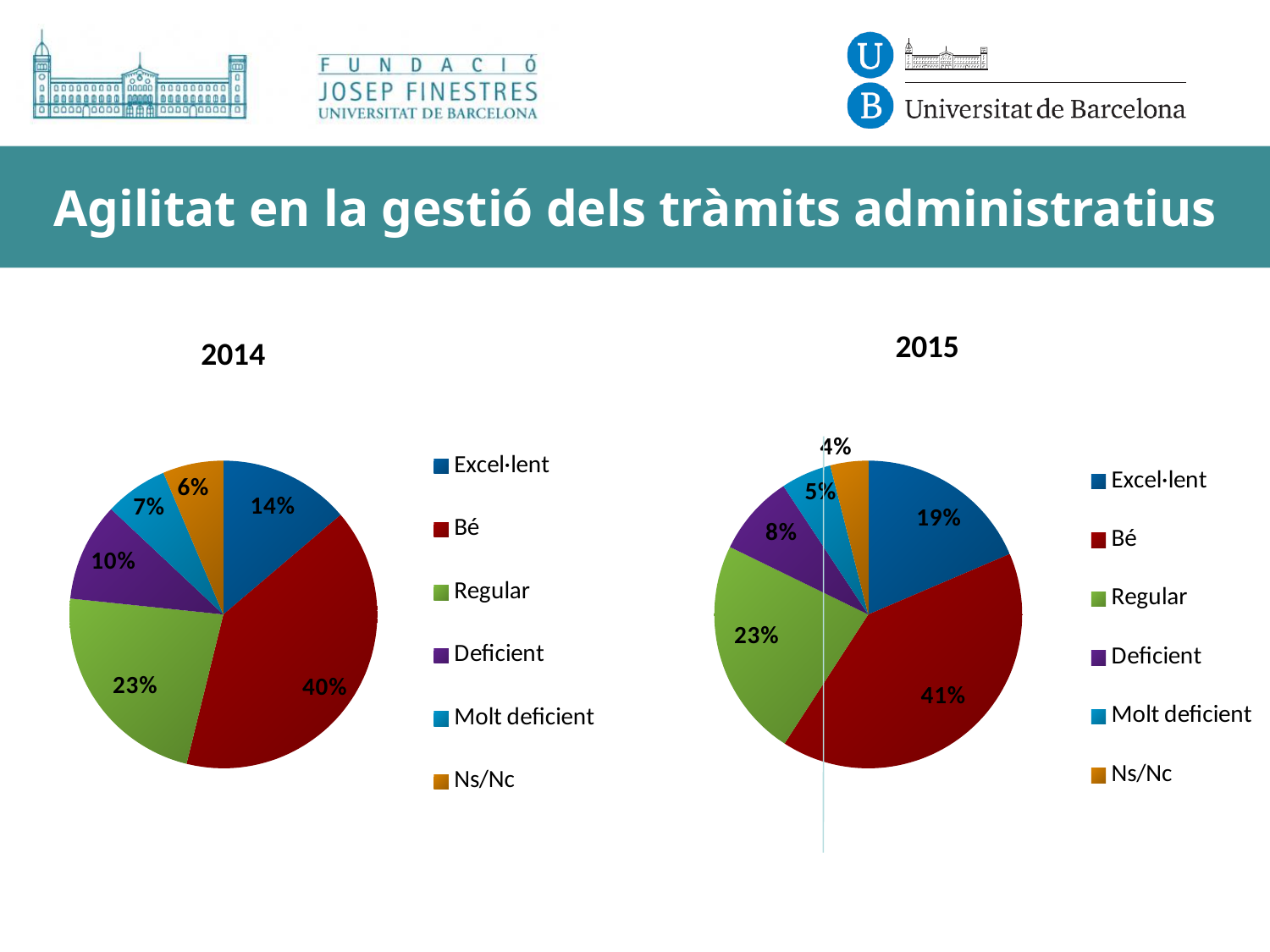
In the 2014 pie chart, what is the difference between the Bé and Regular percentages? 17% In the 2014 pie chart, what percentage is shown for Deficient? 10% What is the title of the chart on the left? 2014 In the 2015 pie chart, what percentage is shown for Ns/Nc? 4% How many slices does the 2015 pie chart have? 6 In the 2014 pie chart, which category has the largest slice? Bé Which is larger: the Excel·lent share in the 2014 pie chart or the Excel·lent share in the 2015 pie chart? 2015 In the 2014 pie chart, what percentage is shown for Bé? 40% In the 2015 pie chart, which category has the smallest slice? Ns/Nc In the 2015 pie chart, what percentage is shown for Molt deficient? 5% In the 2015 pie chart, what percentage is shown for Excel·lent? 19% What type of chart is used for the 2014 data? Pie chart